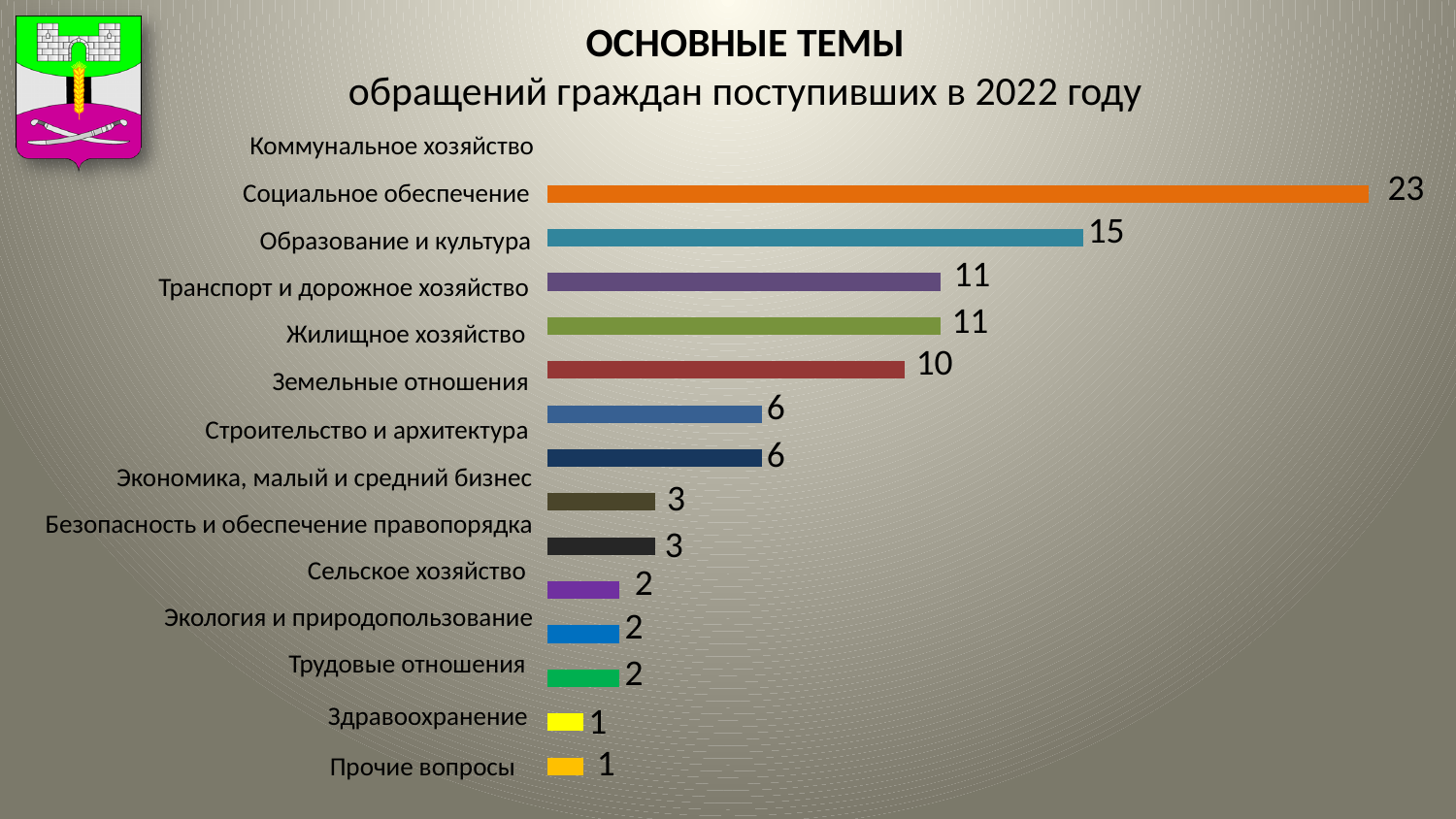
What is the value of the second longest bar in the chart? 15 What kind of chart is shown on the slide? bar chart Do the bar values increase or decrease going from the top of the chart to the bottom? decrease What is the title of the chart on the slide? ОСНОВНЫЕ ТЕМЫ обращений граждан поступивших в 2022 году Is the longest bar in the chart (23) larger than the third longest bar (11)? yes What is the lowest value shown by any bar in the chart? 1 What is the highest value shown by any bar in the chart? 23 How many bars in the chart have the value 2? 3 How many bars are plotted in the chart? 14 What is the difference between the largest bar value (23) and the second largest bar value (15)? 8 How many bars in the chart have the value 11? 2 What colour is the longest bar in the chart? orange